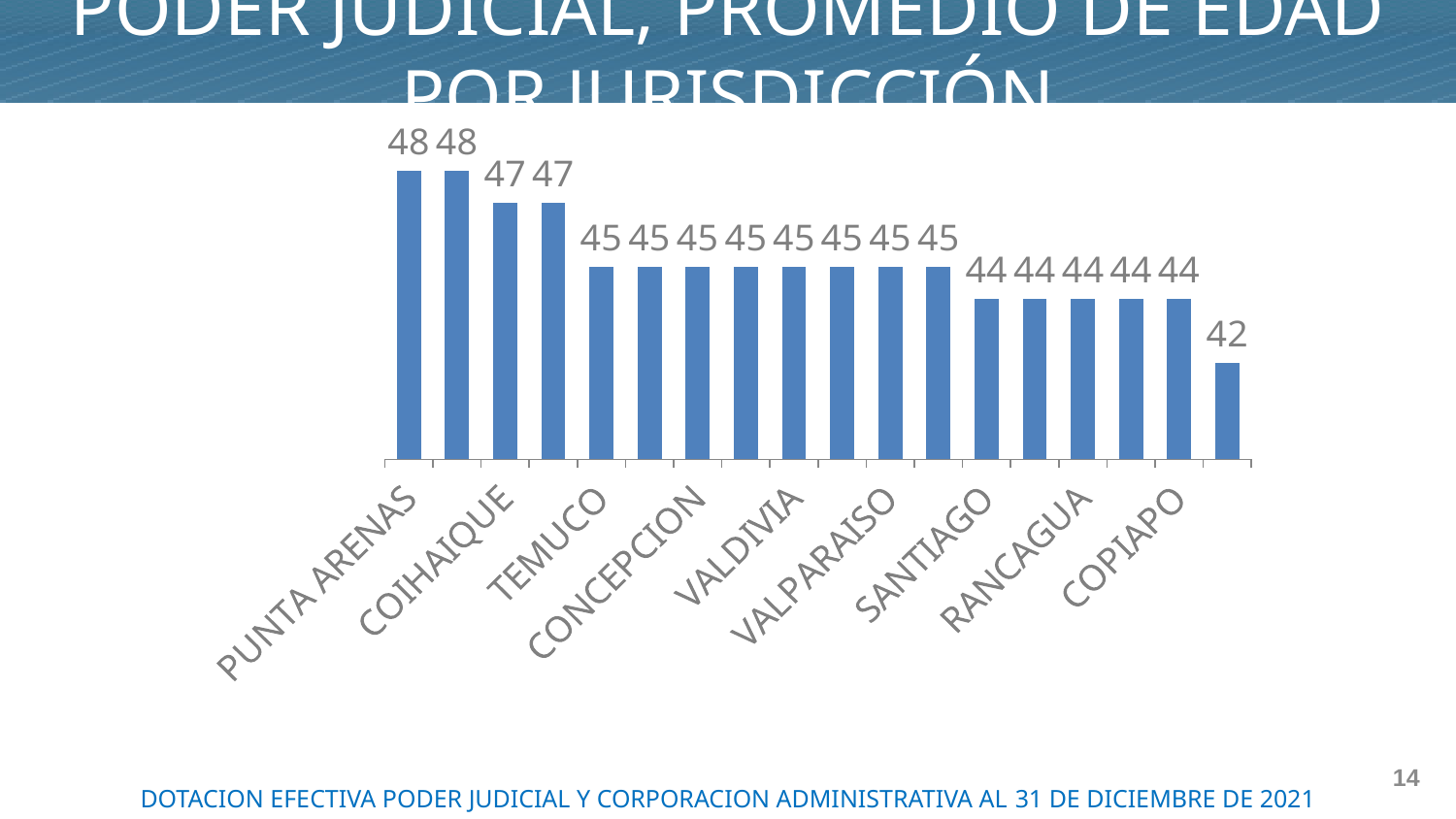
How many bars are plotted on the chart? 18 What is the value shown for COIHAIQUE? 47 What is the average age shown for PUNTA ARENAS? 48 Do the values generally rise or fall from left to right along the x axis? fall What is the difference between the values for PUNTA ARENAS and COPIAPO? 4 What is the value shown for TEMUCO? 45 What is the highest value shown on the chart? 48 What is the lowest value shown on the chart? 42 What is the value shown for SANTIAGO? 44 What is the value shown for COPIAPO? 44 What kind of chart is shown on the slide? bar chart Which has a larger value, PUNTA ARENAS or SANTIAGO? PUNTA ARENAS